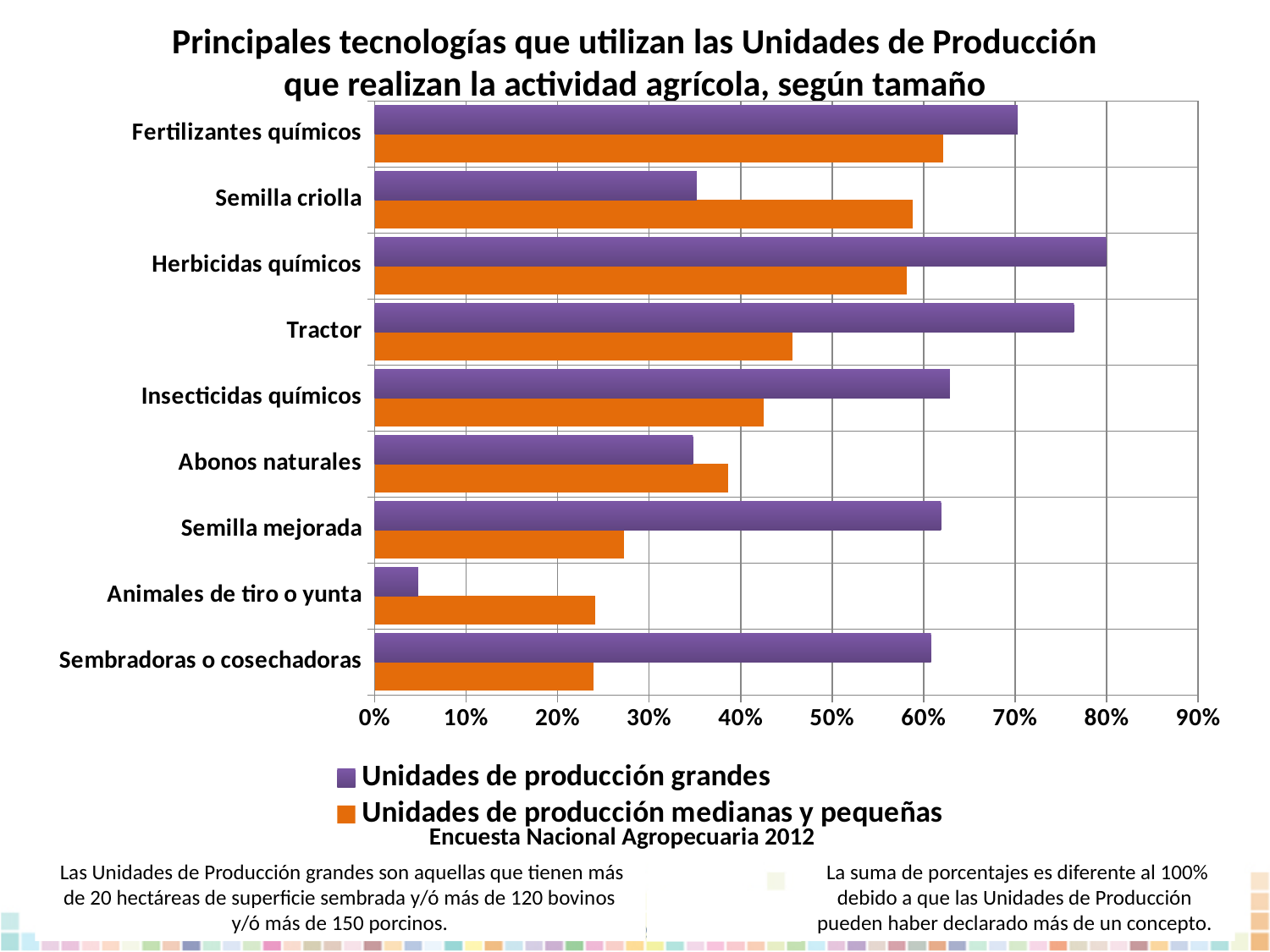
Is the value for Animales de tiro o yunta among Unidades de producción grandes greater or less than 10%? less How many series does the legend list? 2 Is the value for Tractor among Unidades de producción grandes greater or less than 70%? greater For Tractor, which series has the larger value: Unidades de producción grandes or Unidades de producción medianas y pequeñas? Unidades de producción grandes Is the value for Semilla mejorada among Unidades de producción medianas y pequeñas greater or less than 30%? less Which technology has the lowest value for Unidades de producción grandes? Animales de tiro o yunta For Semilla criolla, which series has the larger value: Unidades de producción grandes or Unidades de producción medianas y pequeñas? Unidades de producción medianas y pequeñas Which technology has the highest value for Unidades de producción grandes? Herbicidas químicos How many technology categories are listed on the chart? 9 What colour represents Unidades de producción grandes in the chart? purple Which technology has the highest value for Unidades de producción medianas y pequeñas? Fertilizantes químicos What kind of chart is shown on the slide? bar chart